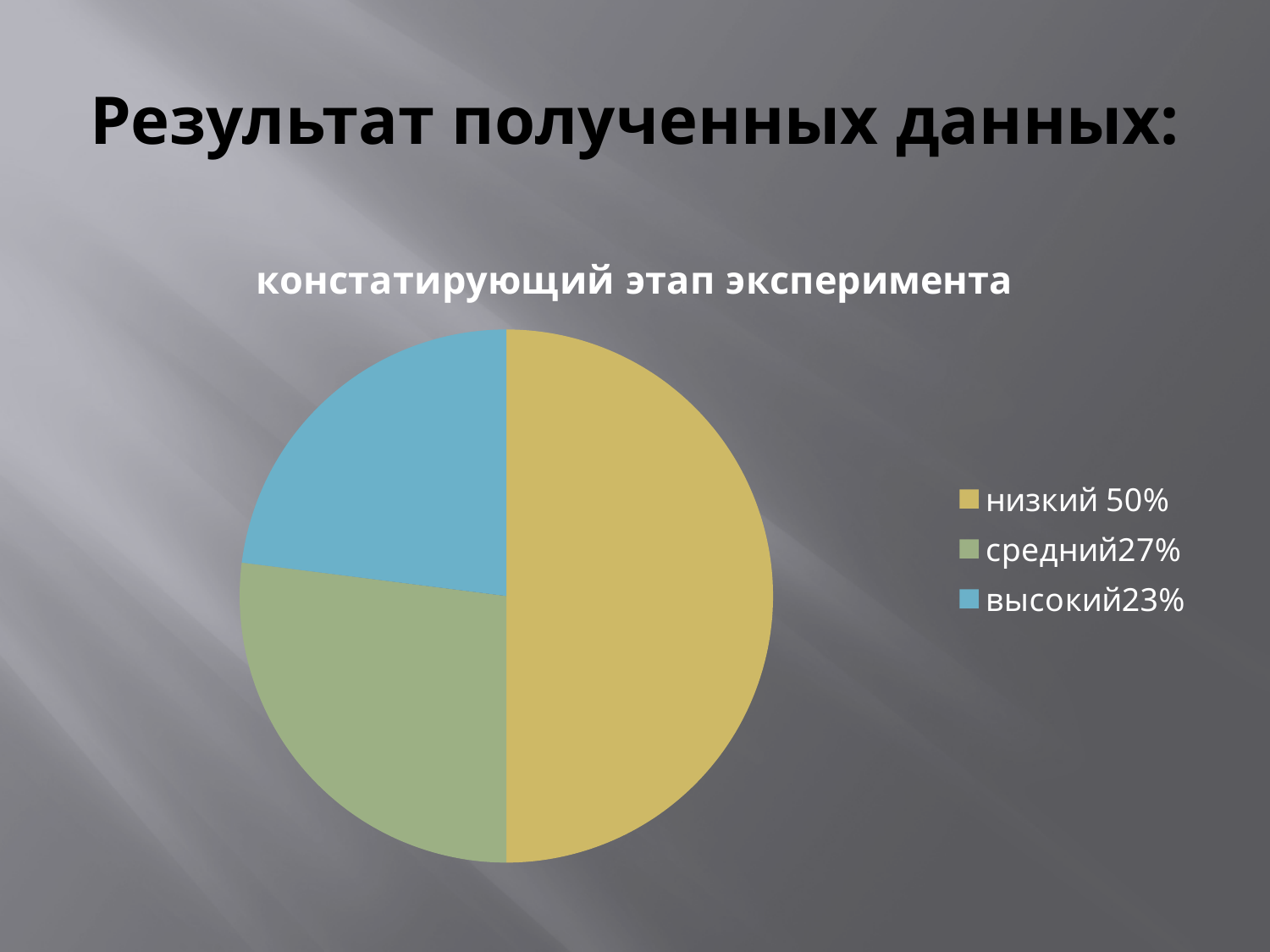
Which category has the smallest slice of the pie? высокий Which is larger, the 'средний' slice or the 'высокий' slice? средний What share of the pie does the 'средний' slice represent? 27% What kind of chart is shown on the slide? pie chart What share of the pie does the 'низкий' slice represent? 50% What is the difference in percentage points between the 'средний' and 'высокий' slices? 4 What is the title of the chart? констатирующий этап эксперимента What share of the pie does the 'высокий' slice represent? 23% What is the difference in percentage points between the 'низкий' and 'средний' slices? 23 How many slices does the pie chart have? 3 What colour is the 'высокий' slice in the pie chart? blue Which category has the largest slice of the pie? низкий